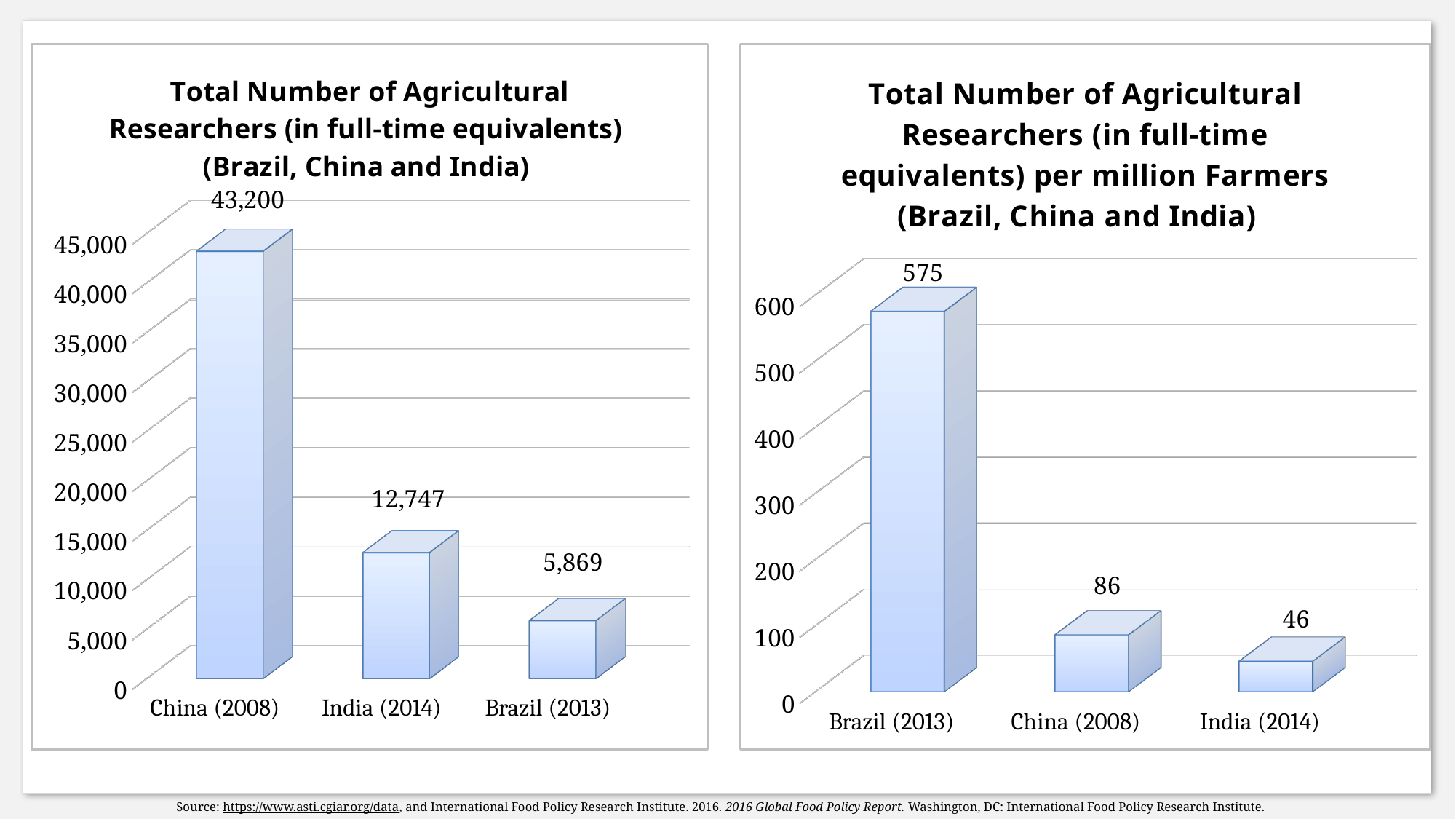
In the left chart (Total Number of Agricultural Researchers), what is the value for Brazil (2013)? 5,869 In the left chart (Total Number of Agricultural Researchers), is the value for India (2014) greater or less than 15,000? less In the right chart (researchers per million Farmers), what is the value for Brazil (2013)? 575 In the right chart (researchers per million Farmers), which is larger: the value for Brazil (2013) or China (2008)? Brazil (2013) In the right chart (researchers per million Farmers), what is the difference between the values for China (2008) and India (2014)? 40 In the right chart (researchers per million Farmers), what is the value for India (2014)? 46 What kind of chart is the left chart (Total Number of Agricultural Researchers)? Bar chart In the left chart (Total Number of Agricultural Researchers), what is the value for China (2008)? 43,200 In the right chart (researchers per million Farmers), which country has the lowest value? India (2014) How many categories are shown in the right chart (researchers per million Farmers)? 3 In the left chart (Total Number of Agricultural Researchers), which country has the highest value? China (2008) In the left chart (Total Number of Agricultural Researchers), what is the difference between the values for China (2008) and India (2014)? 30,453